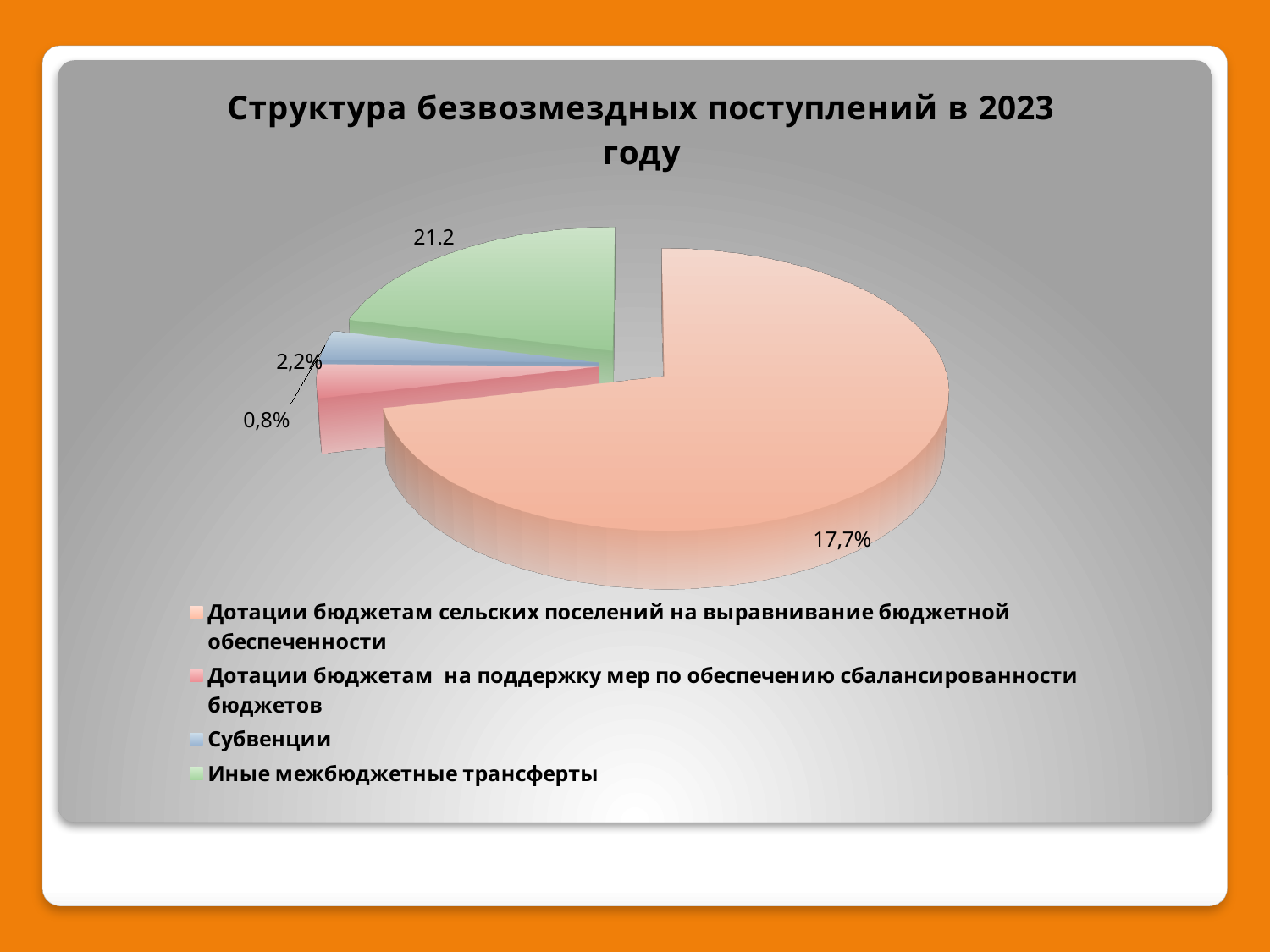
What value is printed on the slice for Дотации бюджетам на поддержку мер по обеспечению сбалансированности бюджетов? 0,8% How many slices does the pie chart have? 4 How many entries does the legend list? 4 What value is printed on the slice for Субвенции? 2,2% What kind of chart is shown on the slide? Pie chart What colour is the slice for Иные межбюджетные трансферты? Green What value is printed on the slice for Иные межбюджетные трансферты? 21.2 What is the difference between the printed values for Субвенции and Дотации бюджетам на поддержку мер по обеспечению сбалансированности бюджетов? 1,4% Which category occupies the largest slice of the pie? Дотации бюджетам сельских поселений на выравнивание бюджетной обеспеченности What is the title of the chart? Структура безвозмездных поступлений в 2023 году Which slice is larger: Дотации бюджетам сельских поселений на выравнивание бюджетной обеспеченности or Иные межбюджетные трансферты? Дотации бюджетам сельских поселений на выравнивание бюджетной обеспеченности What value is printed on the slice for Дотации бюджетам сельских поселений на выравнивание бюджетной обеспеченности? 17,7%